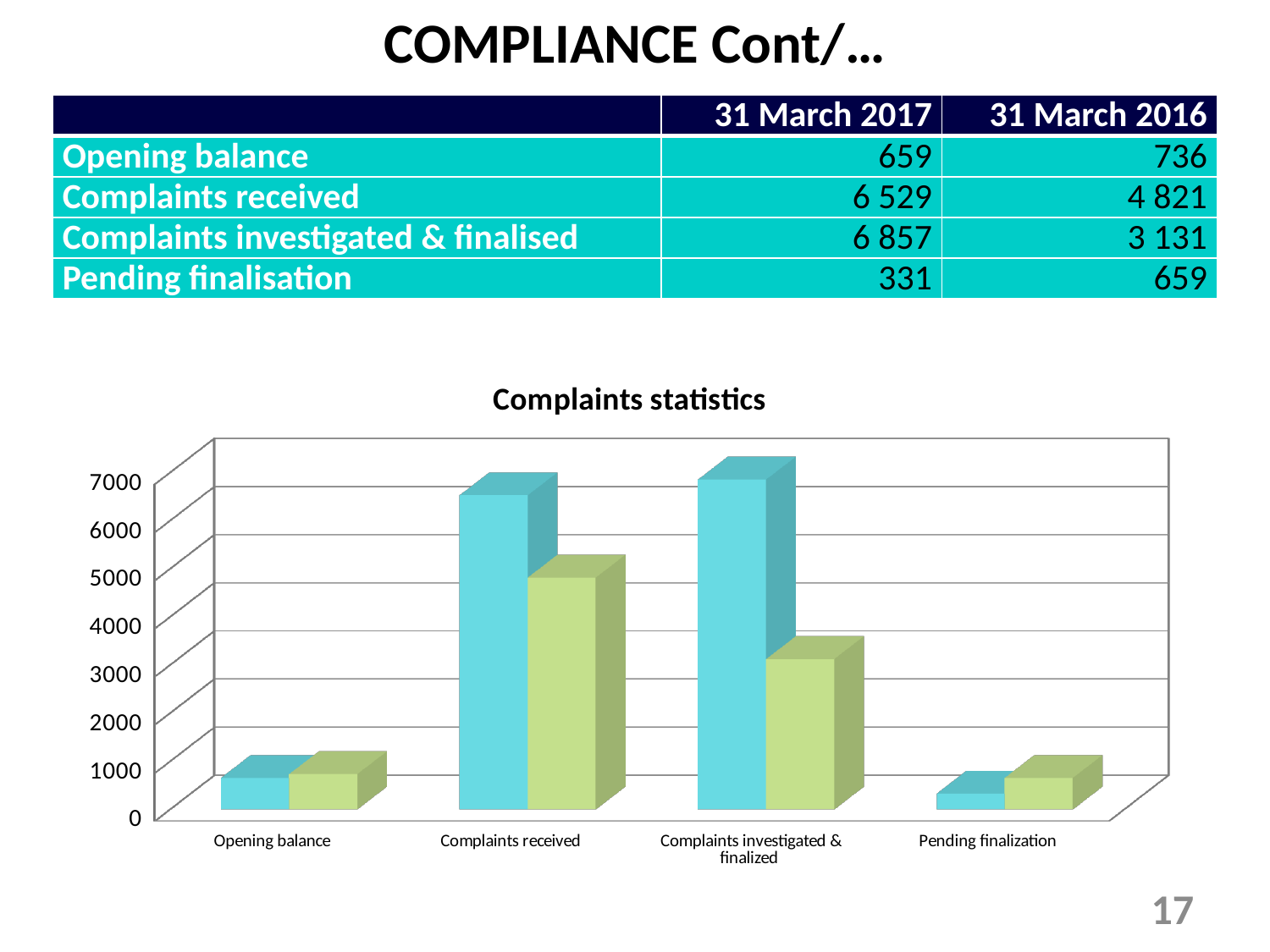
Which category has the tallest green bar in the chart? Complaints received What kind of chart is shown under the title "Complaints statistics"? bar chart In the chart, is the blue bar for Opening balance greater or less than 1000? less In the chart, is the green bar for Complaints investigated & finalized greater or less than 4000? less In the chart, is the blue bar for Complaints received greater or less than 6000? greater Which category has the shortest blue bar in the chart? Pending finalization How many bars are plotted for each category in the chart? 2 Which category has the tallest blue bar in the chart? Complaints investigated & finalized How many categories are shown along the x axis of the chart? 4 For Complaints received, is the blue bar or the green bar taller in the chart? blue What is the title of the chart on the slide? Complaints statistics